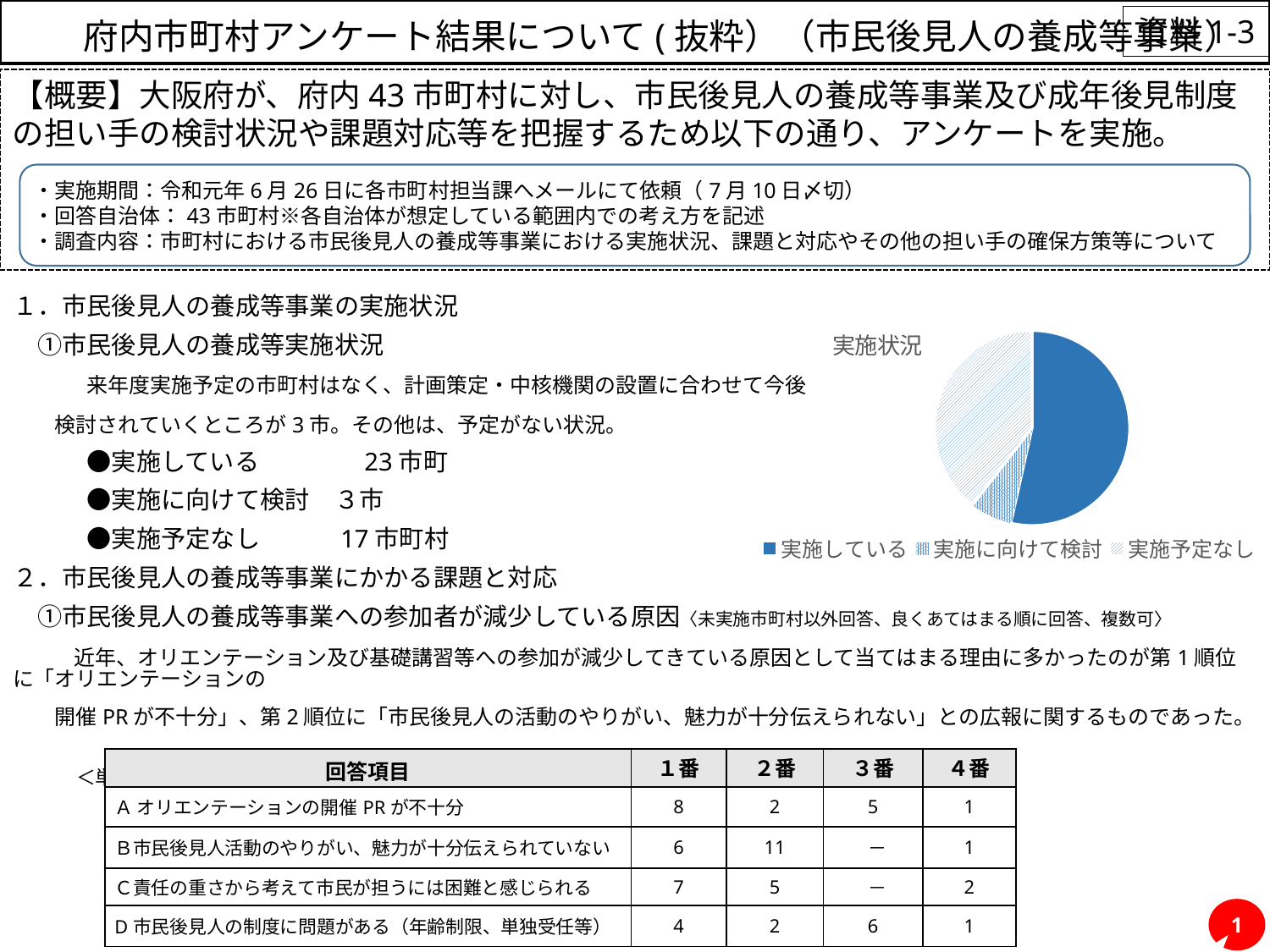
Which legend entry of the pie chart is shown in solid blue? 実施している Which slice is larger in the pie chart, 実施している or 実施予定なし? 実施している What is the difference between the number of municipalities for 実施している and 実施予定なし? 6 How many municipalities are in the 実施に向けて検討 category of the pie chart? 3 市 What is the title of the pie chart? 実施状況 What kind of chart is shown on the slide? pie chart How many municipalities are in the 実施している category of the pie chart? 23 市町 How many municipalities are in the 実施予定なし category of the pie chart? 17 市町村 How many entries does the legend of the pie chart list? 3 Which category has the largest slice in the pie chart? 実施している Which category has the smallest slice in the pie chart? 実施に向けて検討 How many slices does the pie chart have? 3